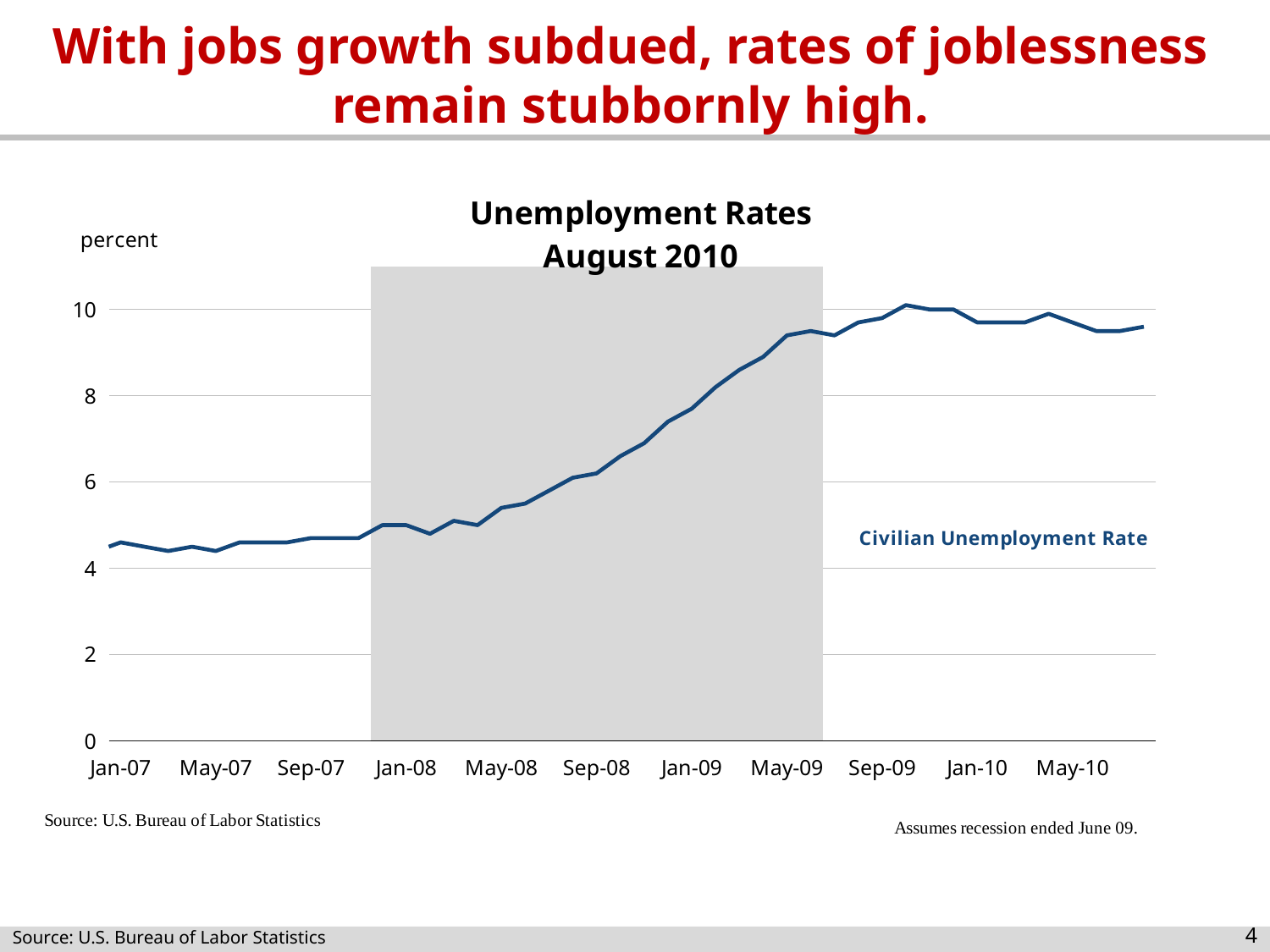
Is the value for Jan-07 greater or less than 4? greater Which is larger, the value for Jan-07 or the value for Jan-09? Jan-09 How many series are plotted on the chart? 1 What kind of chart is shown on the slide? line chart What is the title of the chart? Unemployment Rates August 2010 Is the value for May-09 greater or less than 8? greater Is the value for Jan-07 greater or less than 6? less Does the unemployment rate rise or fall between Jan-08 and Jan-09? rise What is the name of the series plotted on the chart? Civilian Unemployment Rate How many date labels are shown on the x axis? 11